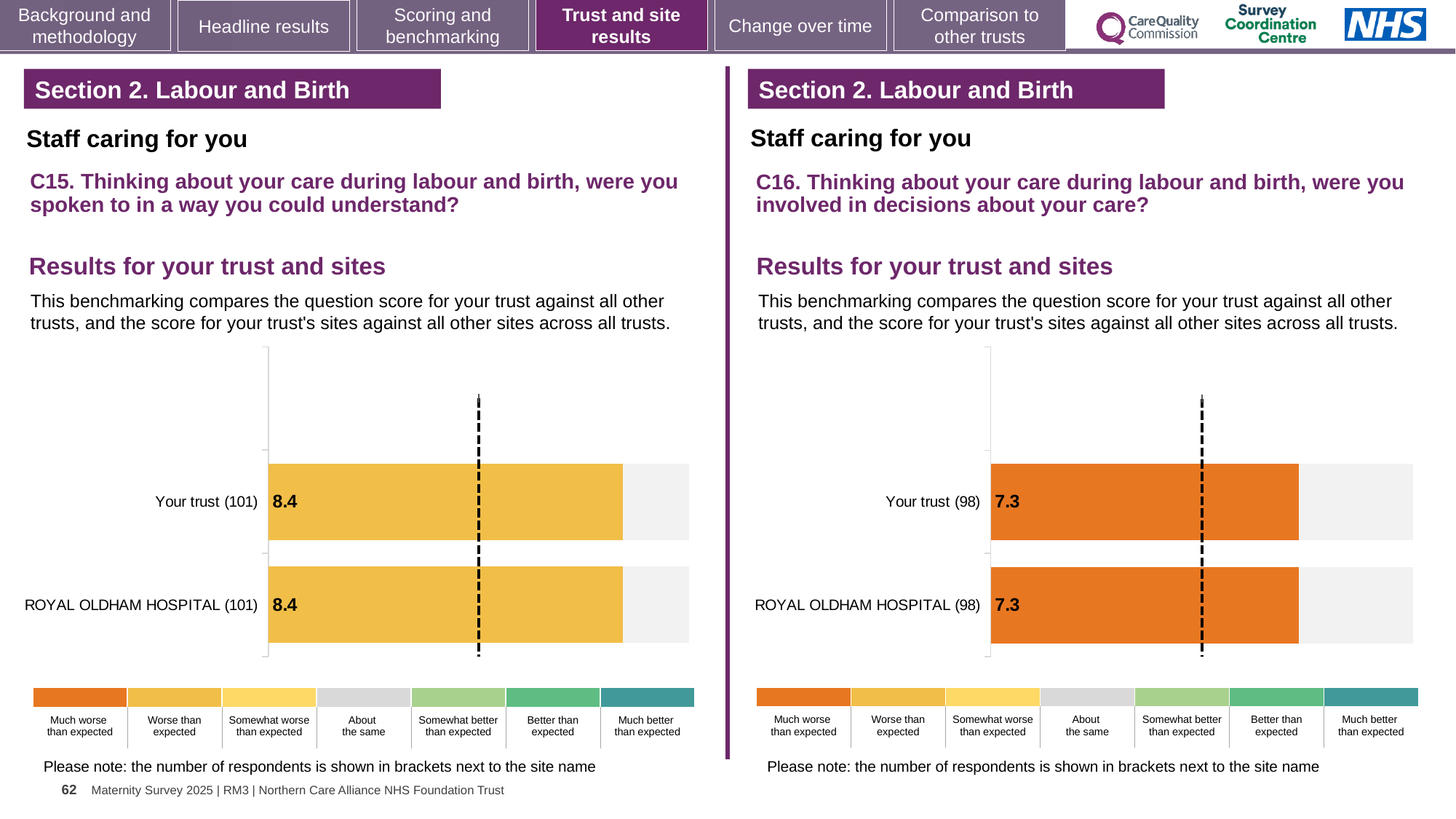
How many bars are plotted in the C16 chart on the right? 2 In the C15 chart on the left, what is the score for Your trust? 8.4 In the C16 chart on the right, how many respondents are shown in brackets for ROYAL OLDHAM HOSPITAL? 98 What type of chart is the C15 chart on the left? Bar chart In the C16 chart on the right, what is the score for ROYAL OLDHAM HOSPITAL? 7.3 In the C15 chart on the left, what is the score for ROYAL OLDHAM HOSPITAL? 8.4 Which chart shows a higher score for Your trust, the C15 chart on the left or the C16 chart on the right? C15 chart on the left What is the difference between the Your trust score in the C15 chart on the left and the Your trust score in the C16 chart on the right? 1.1 In the C15 chart on the left, how many respondents are shown in brackets for Your trust? 101 In the C16 chart on the right, which benchmark category does the bar colour correspond to according to the legend? Much worse than expected In the C16 chart on the right, what is the score for Your trust? 7.3 In the C15 chart on the left, what is the difference between the score for Your trust and the score for ROYAL OLDHAM HOSPITAL? 0